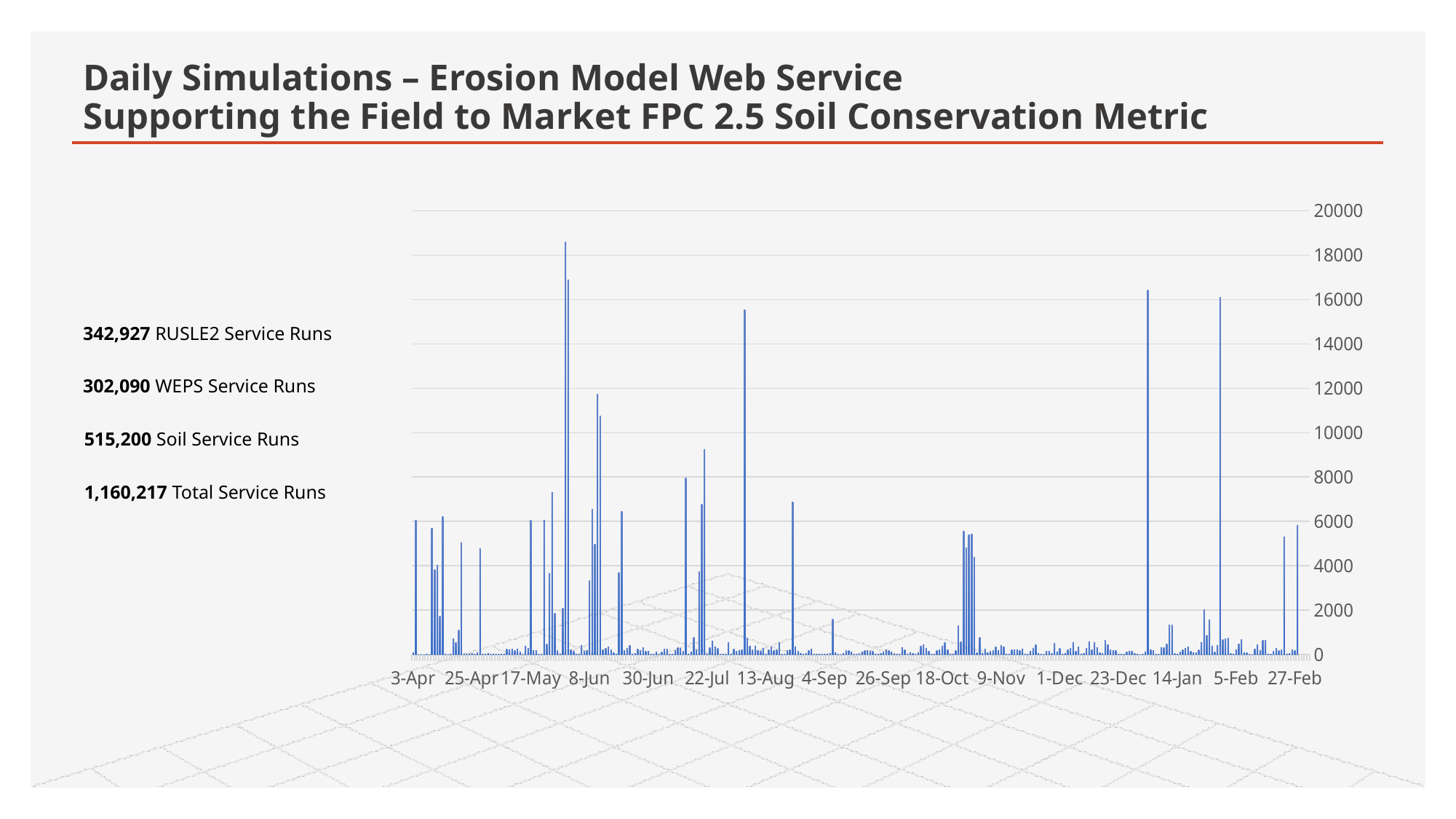
What is the first date label on the horizontal axis? 3-Apr How many date labels are shown along the horizontal axis? 16 Is the tall bar near 4-Sep greater or less than 4000? less Which is taller: the tallest bar shortly before 8-Jun or the tallest bar just before 13-Aug? the bar shortly before 8-Jun What kind of chart is shown on the slide? bar chart What is the interval between consecutive tick labels on the vertical axis? 2000 Is the tallest bar in the chart (shortly before 8-Jun) greater or less than 18000? greater What is the highest value shown on the vertical axis of the chart? 20000 Is the tall bar just before 13-Aug greater or less than 14000? greater